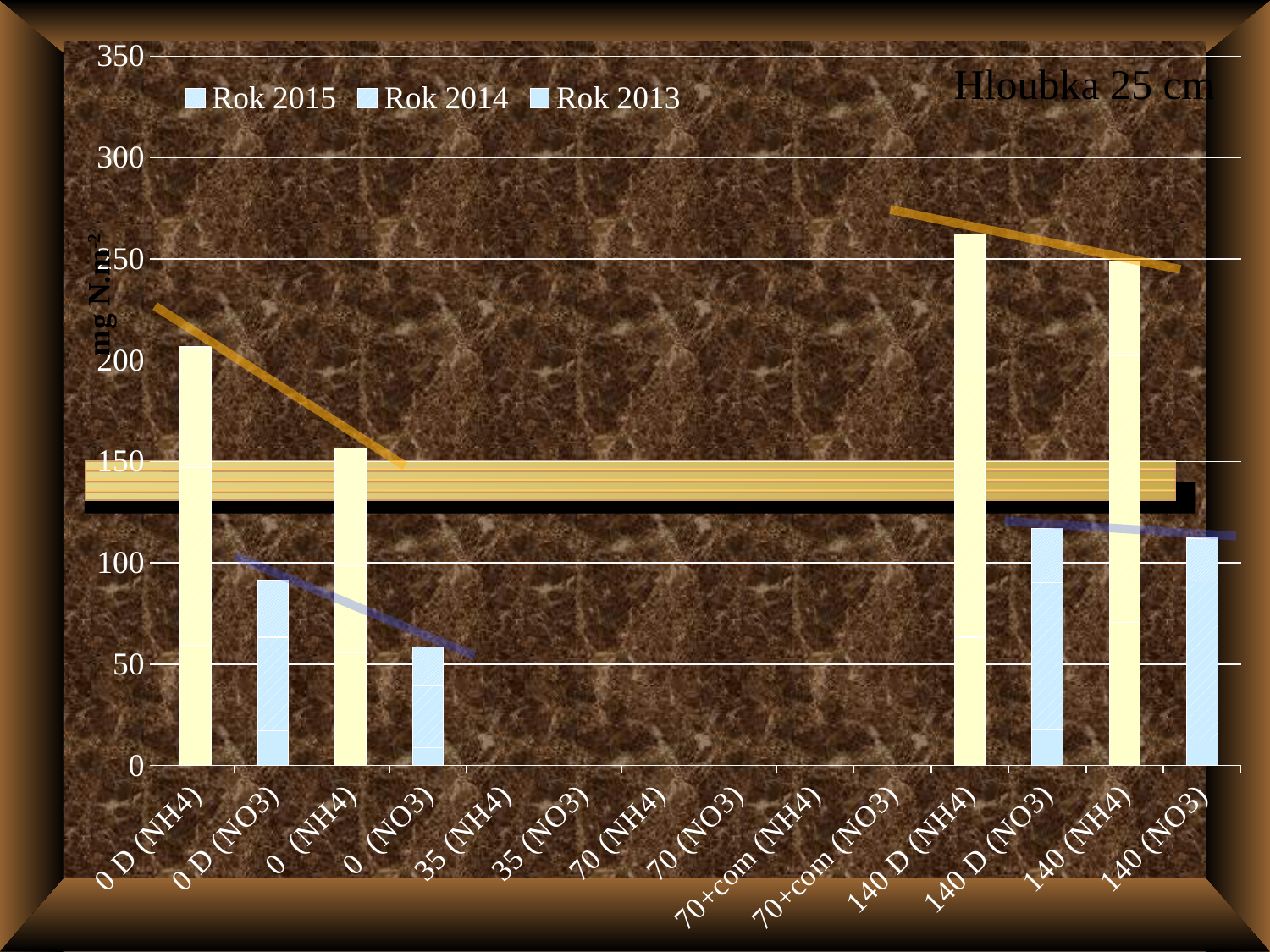
What is the title of the chart? Hloubka 25 cm How many series does the legend list? 3 Which category has the lowest bar among those with visible bars? 0 (NO3) Is the value for 140 D (NH4) greater or less than 200? greater Is the value for 0 D (NH4) greater or less than 150? greater Is the value for 140 (NO3) greater or less than 100? greater Which is larger, the value for 0 D (NH4) or the value for 0 (NH4)? 0 D (NH4) What kind of chart is shown on the slide? bar chart Which series are listed in the legend? Rok 2015, Rok 2014, Rok 2013 How many categories are shown on the x axis? 14